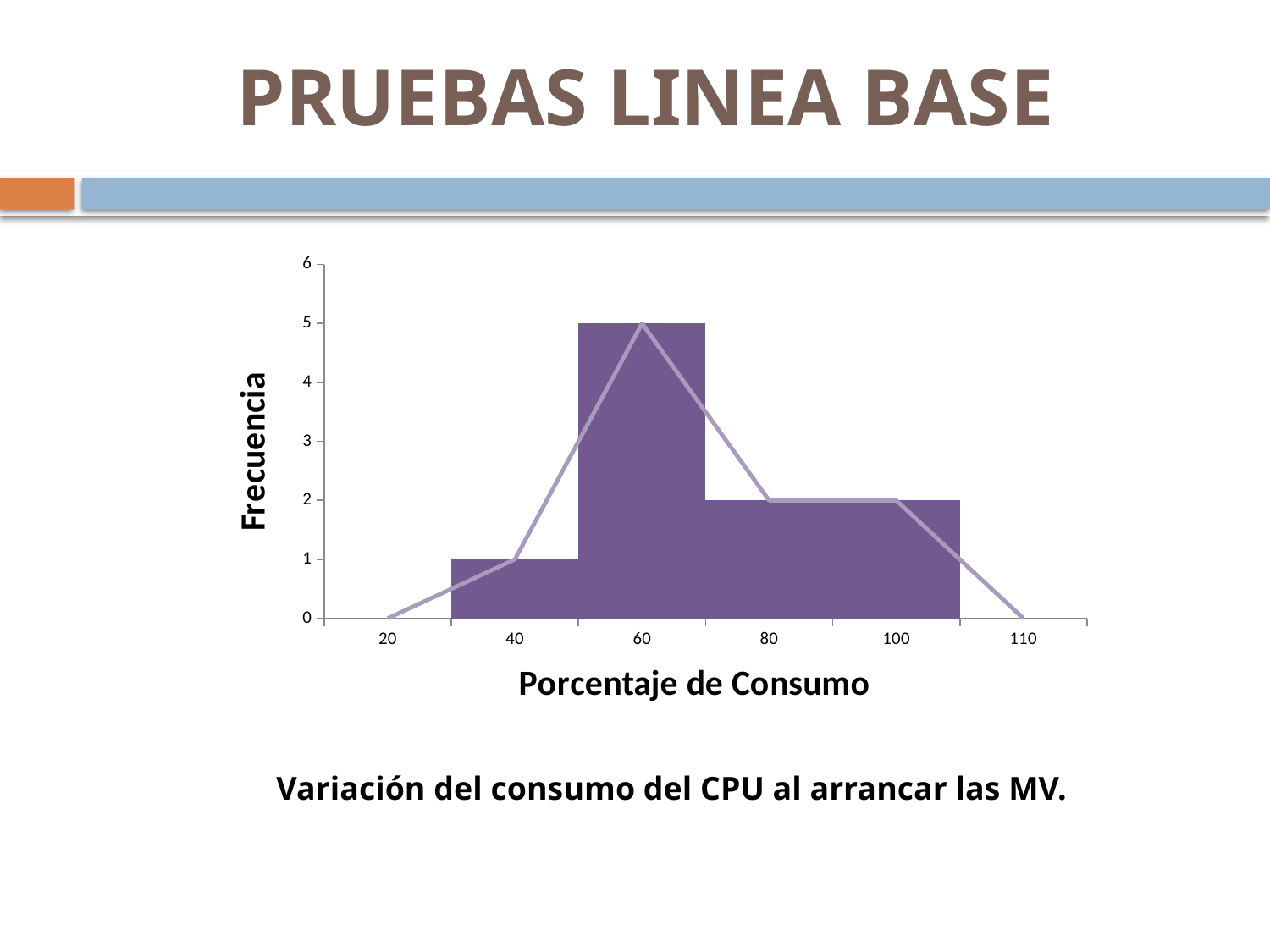
What is the difference in frequency between consumption percentages 60 and 40? 4 What is the label of the x axis? Porcentaje de Consumo What is the frequency for a consumption percentage of 60? 5 What is the frequency shown by the line at consumption percentage 110? 0 Is the frequency for consumption percentage 60 greater or less than 4? greater What is the frequency for a consumption percentage of 40? 1 What is the frequency for a consumption percentage of 80? 2 Which has a higher frequency, consumption percentage 60 or 80? 60 Does the frequency rise or fall from consumption percentage 60 to 80? fall What is the label of the y axis? Frecuencia What is the frequency for a consumption percentage of 100? 2 Which consumption percentage has the highest frequency? 60